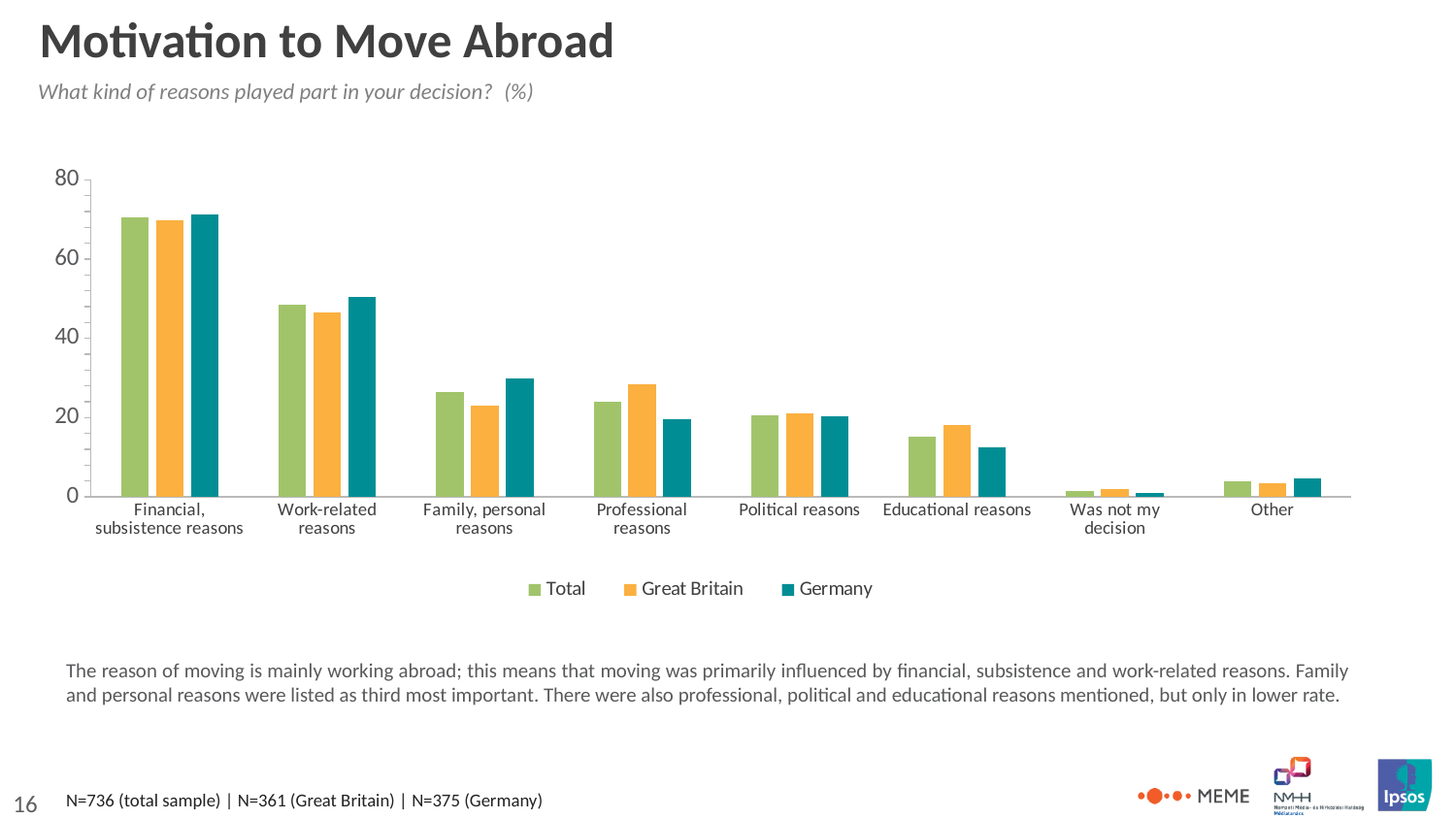
Which series are listed in the chart's legend? Total, Great Britain, Germany Is the Germany value for Family, personal reasons greater or less than 20? greater Is the Total value for Financial, subsistence reasons greater or less than 60? greater Is the Germany value for Work-related reasons greater or less than 40? greater For Family, personal reasons, which is larger: the Germany value or the Great Britain value? Germany Which category has the highest value for the Total series? Financial, subsistence reasons What kind of chart is shown on the slide? Bar chart How many reason categories are shown on the x axis of the chart? 8 Which category has the lowest value for the Total series? Was not my decision For Professional reasons, which is larger: the Great Britain value or the Germany value? Great Britain How many series does the chart's legend list? 3